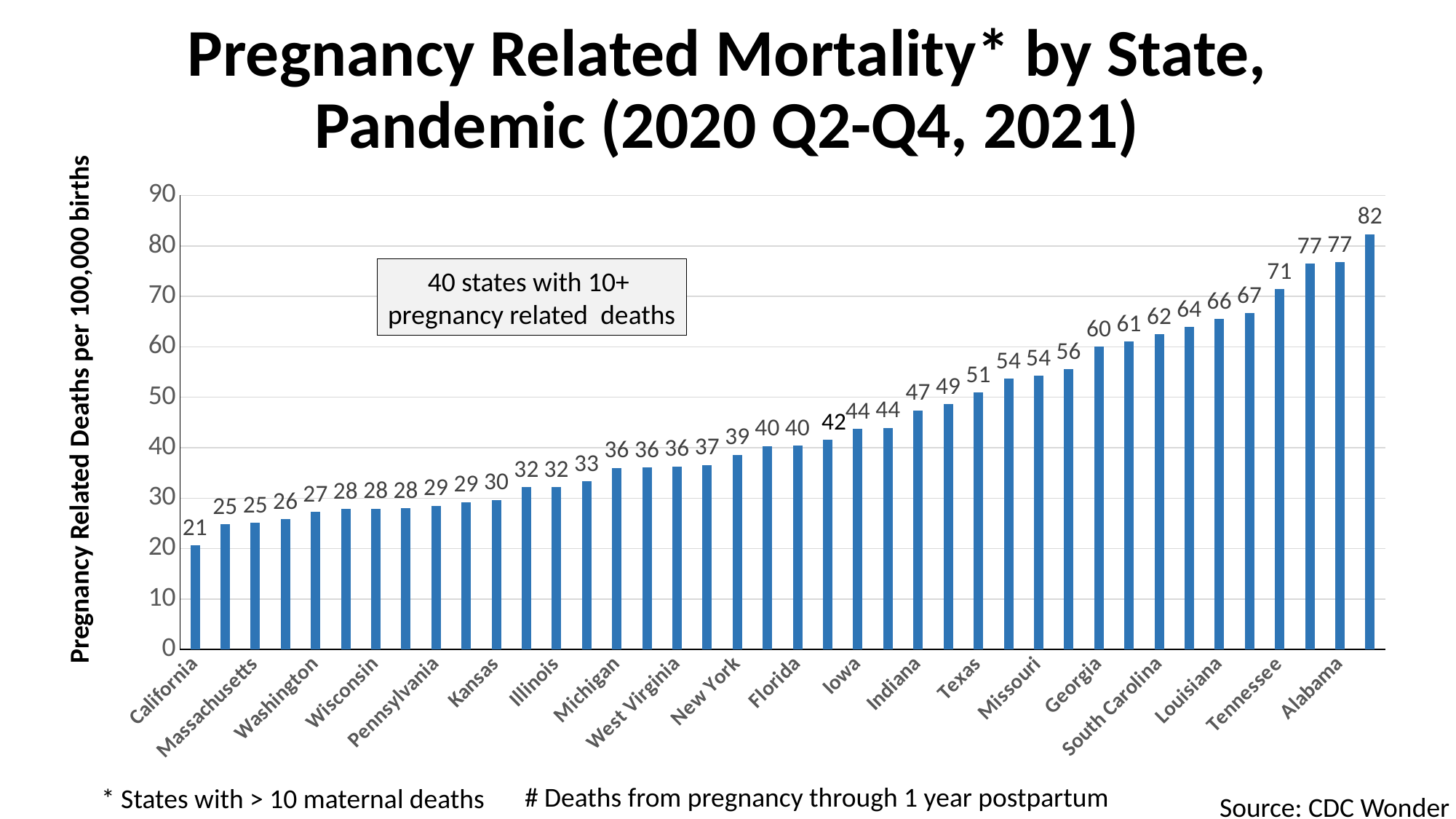
What is the value shown for Wisconsin? 28 What is the highest value shown on the chart? 82 Which has the larger value, Georgia or Florida? Georgia What is the value shown for Alabama? 77 What is the value shown for Michigan? 36 Is the value for Georgia greater or less than 50? greater Do the values rise or fall moving from left to right along the x axis? Rise What is the label on the vertical axis? Pregnancy Related Deaths per 100,000 births What kind of chart is shown on the slide? Bar chart What is the pregnancy related mortality value for California? 21 Which state has the lowest pregnancy related mortality on the chart? California How many states (bars) are plotted on the chart? 40